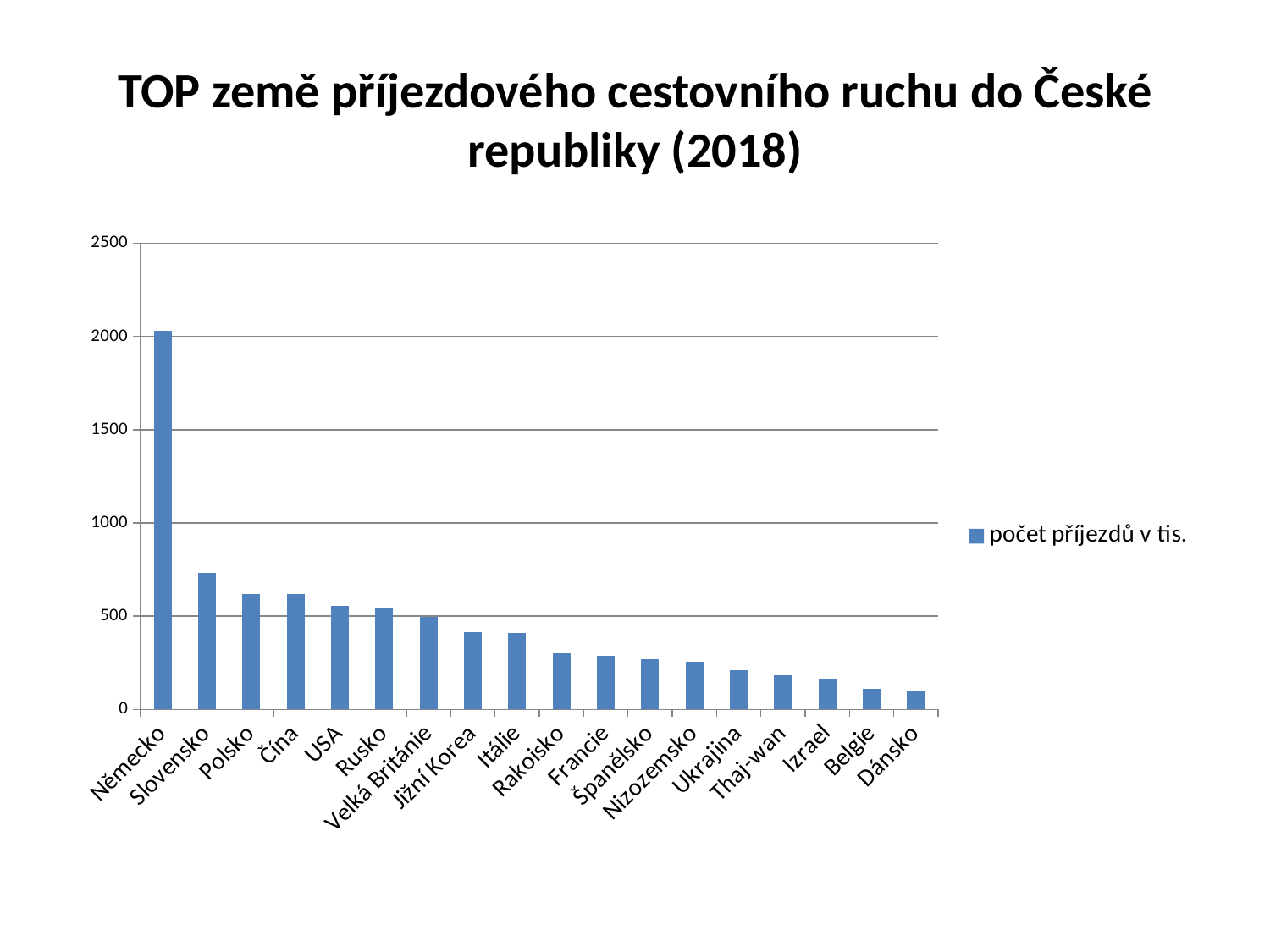
Is the value for Dánsko greater or less than 500? less Is the value for Slovensko greater or less than 1000? less How many countries are shown on the x axis of the chart? 18 Which country has the highest number of arrivals in the chart? Německo Which has a larger value, Německo or Slovensko? Německo What kind of chart is shown on the slide? bar chart Is the value for Jižní Korea greater or less than 500? less How many series does the legend list? 1 Do the values rise or fall from left to right along the x axis? fall